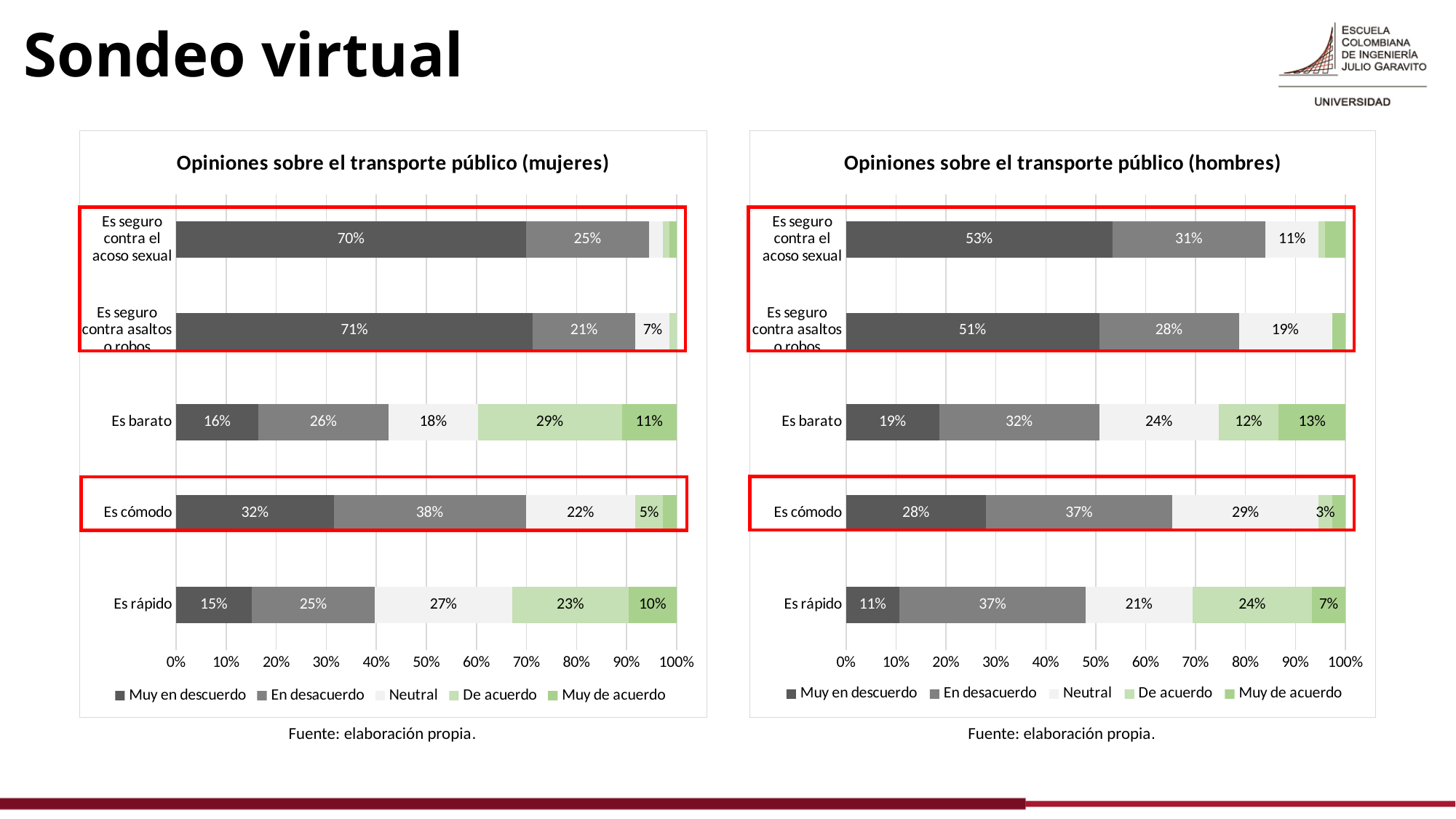
What kind of chart is 'Opiniones sobre el transporte público (mujeres)'? Stacked bar chart In the chart 'Opiniones sobre el transporte público (mujeres)', what is the 'Muy en descuerdo' value for 'Es seguro contra el acoso sexual'? 70% How many categories are shown in the chart 'Opiniones sobre el transporte público (mujeres)'? 5 In the chart 'Opiniones sobre el transporte público (hombres)', what is the 'Neutral' value for 'Es seguro contra asaltos o robos'? 19% In the chart 'Opiniones sobre el transporte público (hombres)', is the 'Muy en descuerdo' value for 'Es seguro contra el acoso sexual' greater or less than 50%? greater In the chart 'Opiniones sobre el transporte público (hombres)', what is the 'Muy de acuerdo' value for 'Es rápido'? 7% In the chart 'Opiniones sobre el transporte público (mujeres)', which category has the highest 'Muy en descuerdo' value? Es seguro contra asaltos o robos In the chart 'Opiniones sobre el transporte público (hombres)', which category has the lowest 'Muy en descuerdo' value? Es rápido In the chart 'Opiniones sobre el transporte público (mujeres)', which is larger for 'Es cómodo': the 'Muy en descuerdo' value or the 'En desacuerdo' value? En desacuerdo How many series does the legend list in the chart 'Opiniones sobre el transporte público (hombres)'? 5 In the chart 'Opiniones sobre el transporte público (mujeres)', what is the 'De acuerdo' value for 'Es barato'? 29% In the chart 'Opiniones sobre el transporte público (hombres)', what is the difference between the 'En desacuerdo' values for 'Es rápido' and 'Es seguro contra asaltos o robos'? 9%